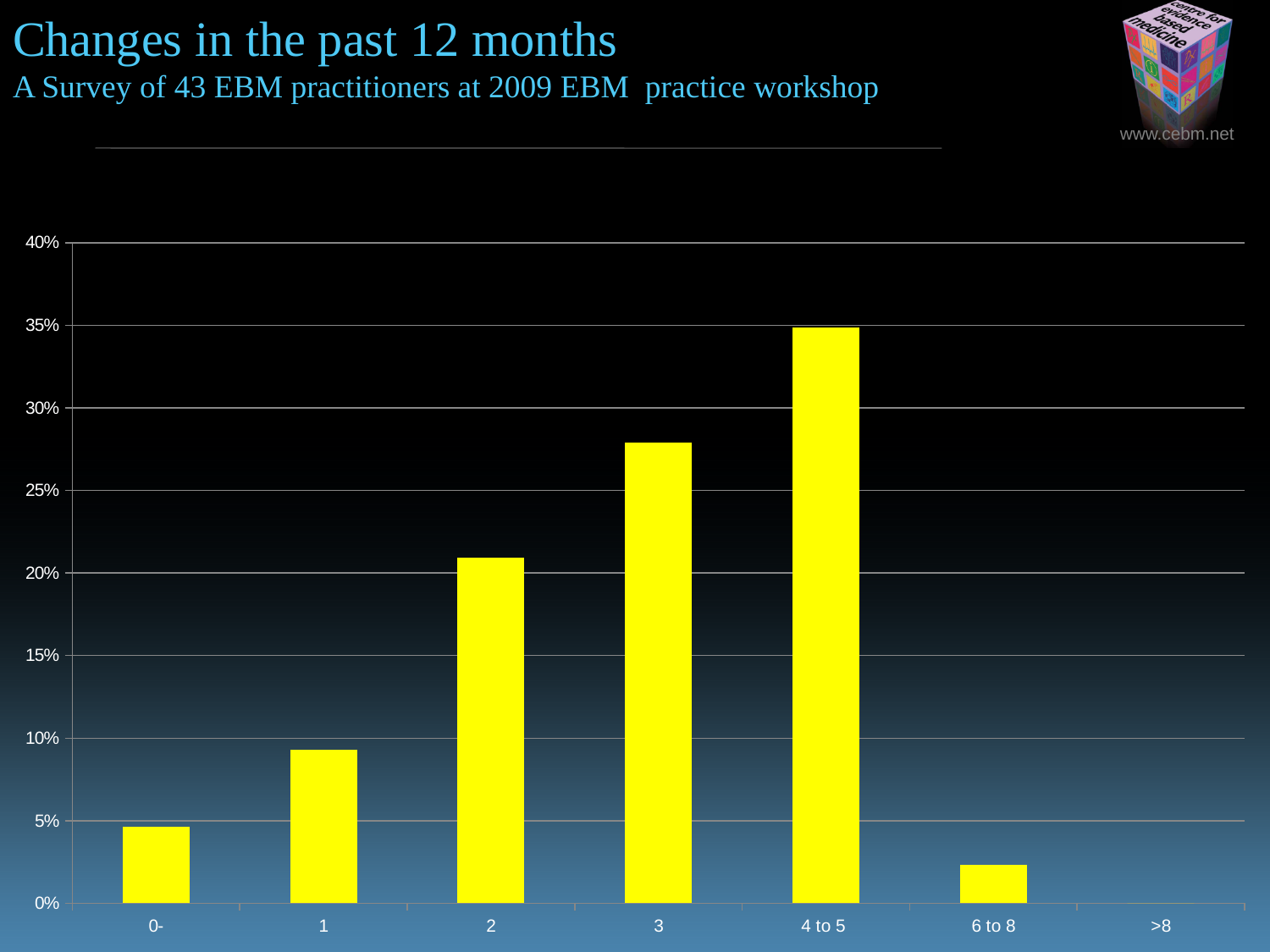
How many categories are shown on the x axis of the chart? 7 What kind of chart is shown on the slide? bar chart Is the value for "0-" greater or less than 10%? less Is the value for "2" greater or less than 25%? less Which category has the highest value in the chart? 4 to 5 What colour are the bars in the chart? yellow Is the value for "1" greater or less than 5%? greater Do the values rise or fall from the "0-" category to the "4 to 5" category? rise Which is larger, the value for "0-" or the value for "6 to 8"? 0-